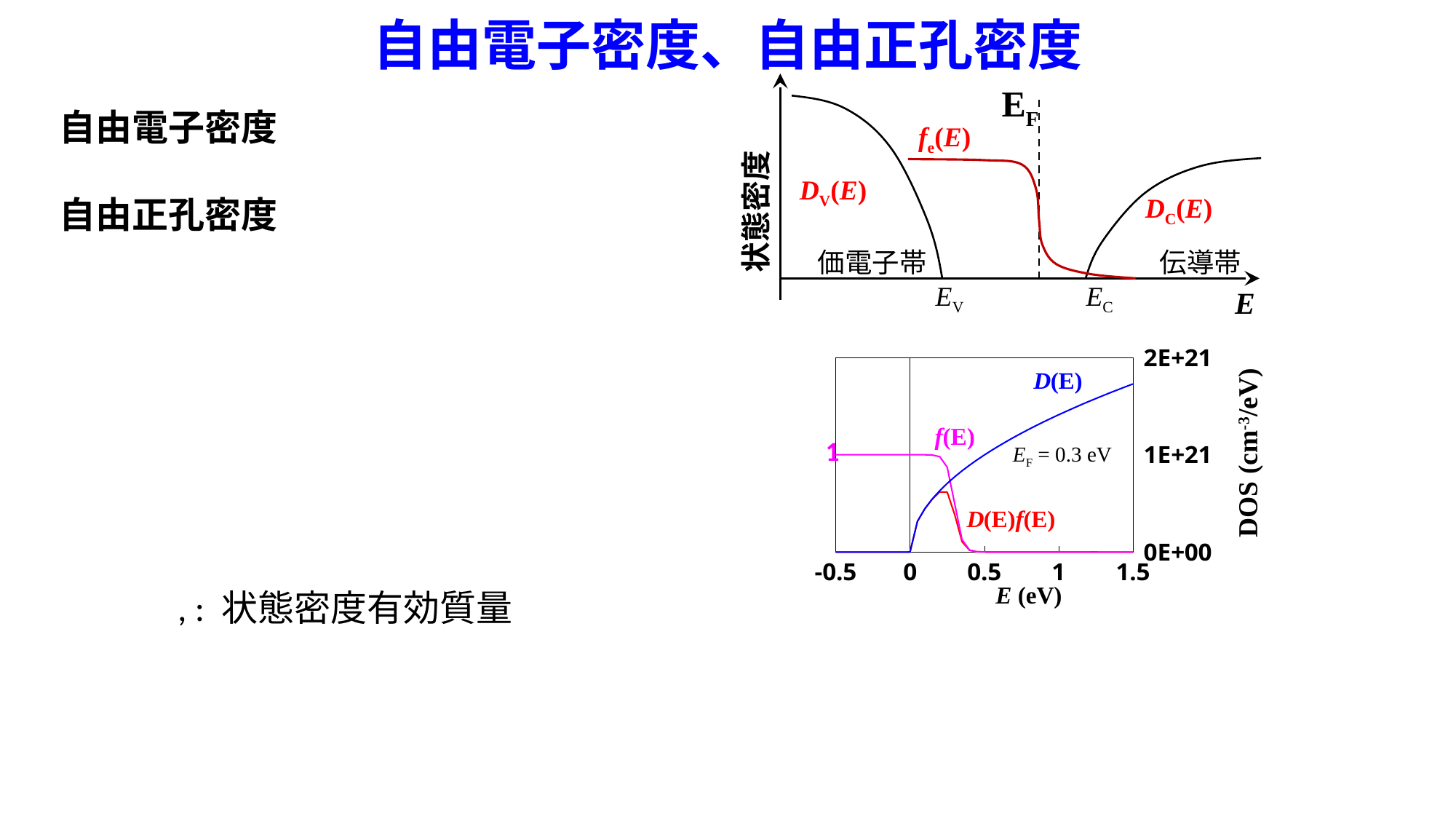
How many curves are drawn in the upper chart? 3 In the lower chart, what is the label of the vertical axis? DOS (cm^-3/eV) In the lower chart, what is the highest tick value shown on the DOS axis? 2E+21 In the lower chart, what value of E_F is printed? 0.3 eV In the lower chart, is the value of D(E) at E = 1 eV greater or less than 1E+21? greater In the lower chart, does f(E) rise or fall as E increases past 0.3 eV? fall In the upper chart, which curve is drawn in red? f_e(E) In the lower chart, what is the lowest value shown on the E (eV) axis? -0.5 In the lower chart, is the value of D(E) at E = 1.5 eV greater or less than 1E+21? greater In the lower chart, does D(E) rise or fall as E increases from 0 to 1.5 eV? rise What kind of chart is the lower chart with the E (eV) axis? line chart How many curves are plotted in the lower chart? 3